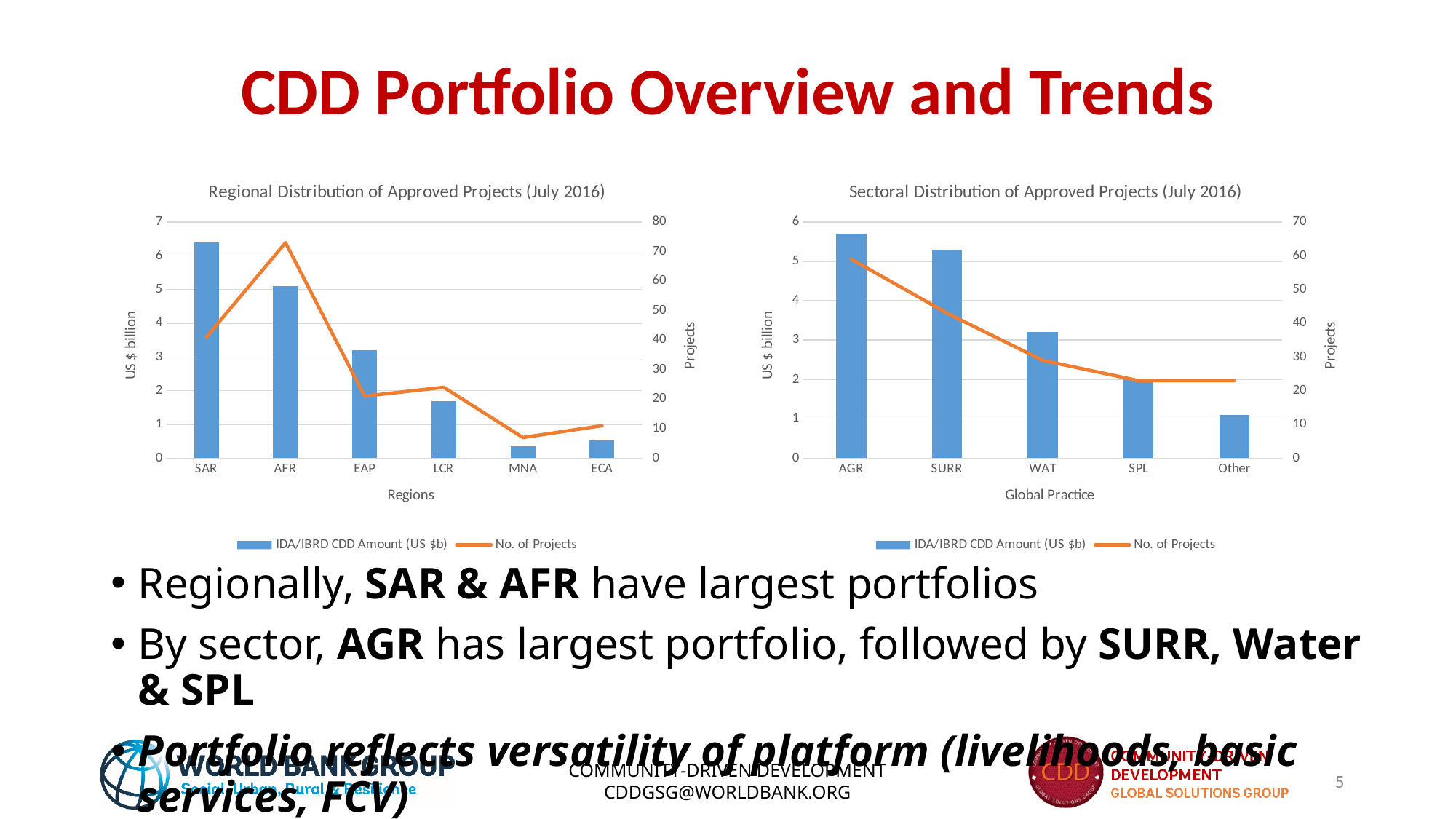
In the Regional Distribution chart, which region has the lowest IDA/IBRD CDD Amount? MNA In the Regional Distribution chart, is the IDA/IBRD CDD Amount for EAP greater or less than 4? less In the Regional Distribution chart, is the No. of Projects for AFR greater or less than 60? greater In the Sectoral Distribution chart, which has a larger IDA/IBRD CDD Amount, SURR or WAT? SURR In the Regional Distribution chart, which region has the highest IDA/IBRD CDD Amount? SAR How many series does the legend of the Sectoral Distribution chart list? 2 What is the label of the right-hand vertical axis on the Regional Distribution chart? Projects How many regions are shown on the x axis of the Regional Distribution chart? 6 In the Regional Distribution chart, which region has the highest No. of Projects? AFR In the Sectoral Distribution chart, which Global Practice has the highest IDA/IBRD CDD Amount? AGR In the Sectoral Distribution chart, which Global Practice has the lowest IDA/IBRD CDD Amount? Other In the Sectoral Distribution chart, is the IDA/IBRD CDD Amount for WAT greater or less than 3? greater